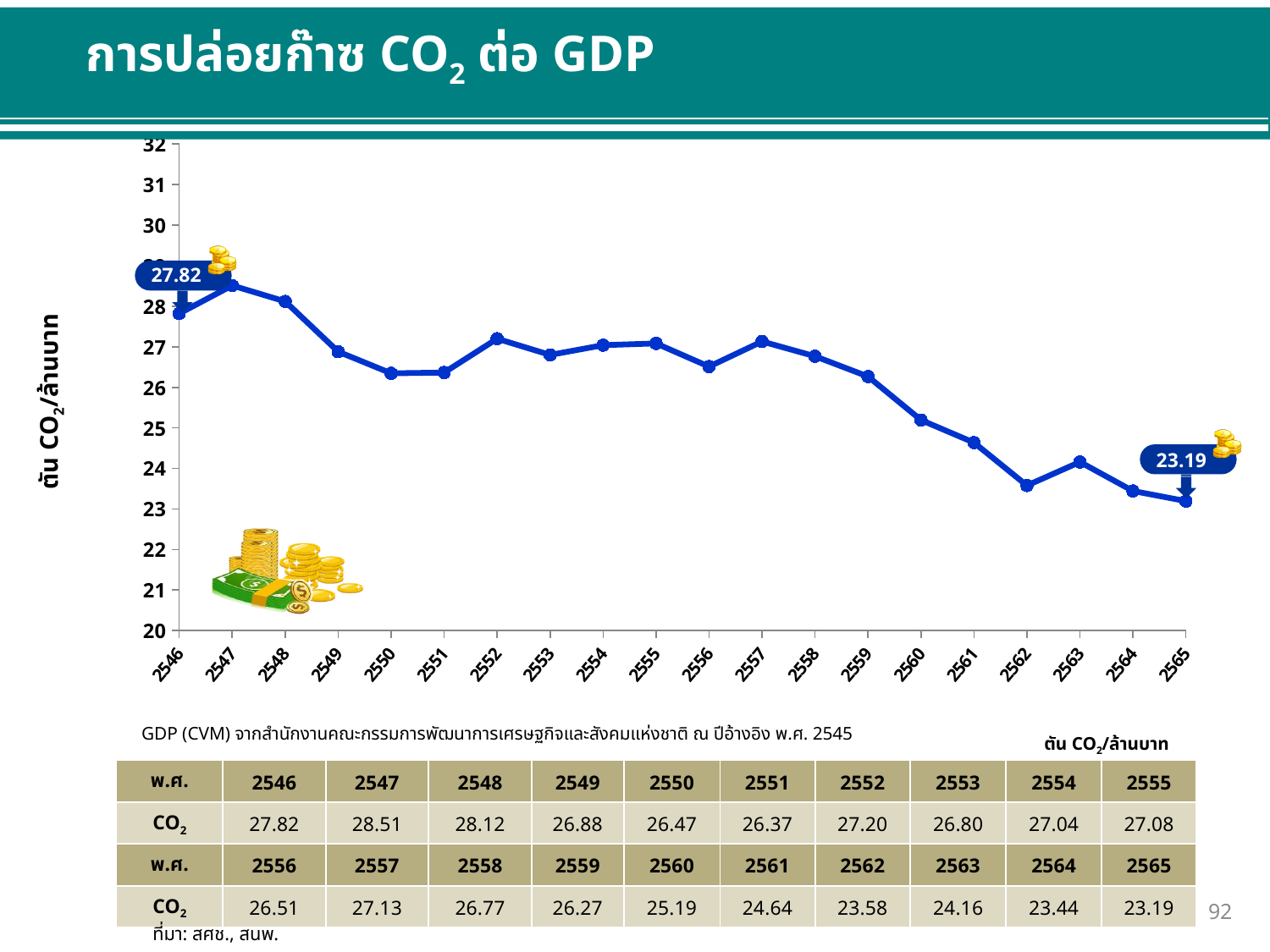
How many years are plotted on the x axis? 20 What is the CO2 per GDP value for the year 2565? 23.19 What is the CO2 per GDP value for the year 2560? 25.19 What type of chart is shown on the slide? line chart Do the values generally rise or fall from 2547 to 2565? fall What is the difference between the values for 2547 and 2565? 5.32 What is the CO2 per GDP value for the year 2546? 27.82 Which year has the larger value, 2552 or 2553? 2552 What is the difference between the values for 2546 and 2565? 4.63 Is the value for 2562 greater or less than 24? less Which year has the highest CO2 per GDP value? 2547 Which year has the lowest CO2 per GDP value? 2565